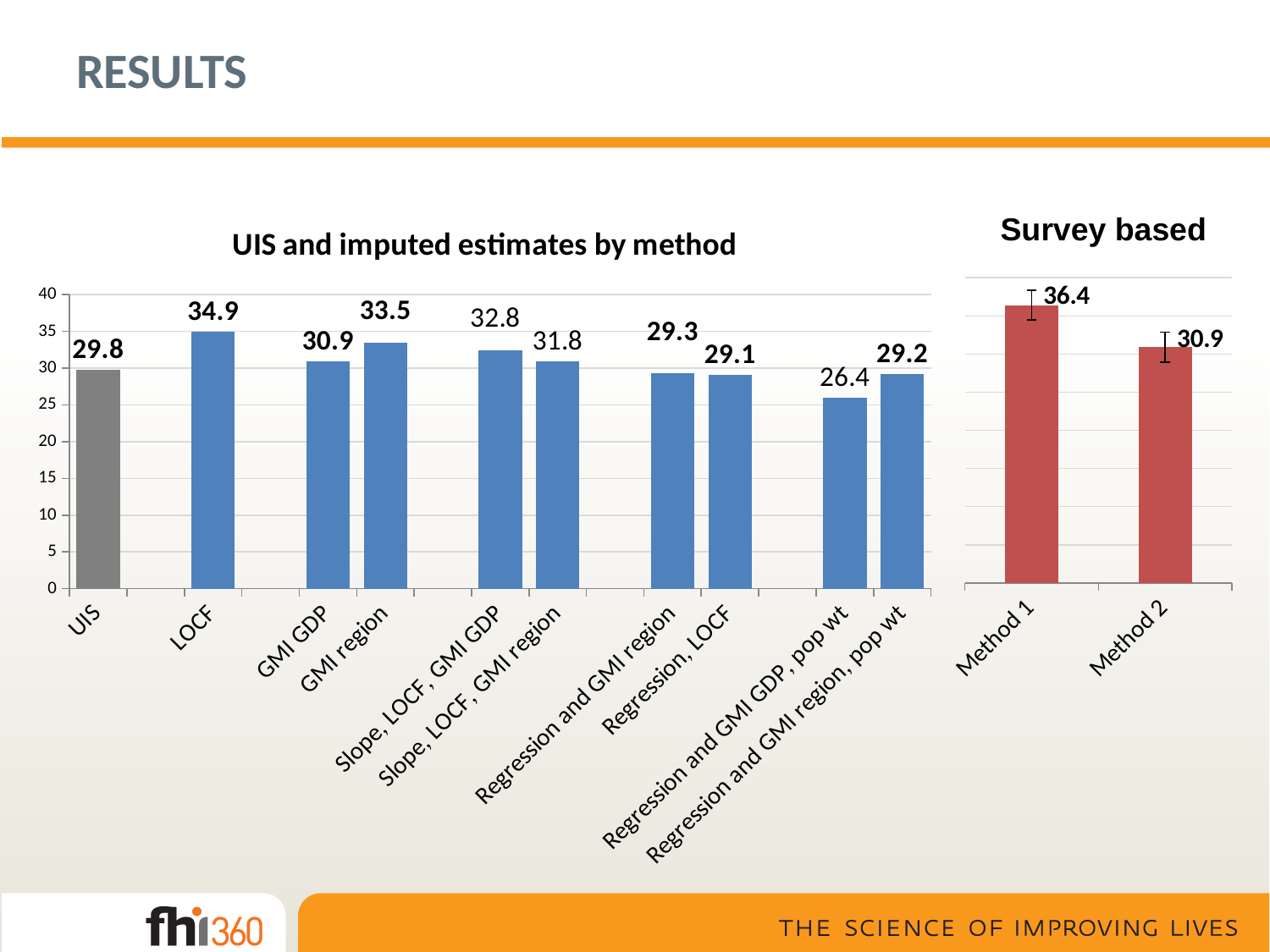
In the 'Survey based' chart, what is the difference between Method 1 and Method 2? 5.5 In the 'Survey based' chart, what is the value for Method 2? 30.9 In the 'UIS and imputed estimates by method' chart, which category has the lowest value? Regression and GMI GDP, pop wt In the 'UIS and imputed estimates by method' chart, which is larger: GMI GDP or GMI region? GMI region In the 'UIS and imputed estimates by method' chart, what is the value for UIS? 29.8 In the 'UIS and imputed estimates by method' chart, which category has the highest value? LOCF How many categories are shown in the 'UIS and imputed estimates by method' chart? 10 In the 'UIS and imputed estimates by method' chart, what is the difference between the LOCF value and the UIS value? 5.1 What type of chart is the 'Survey based' chart? Bar chart In the 'Survey based' chart, what is the value for Method 1? 36.4 In the 'UIS and imputed estimates by method' chart, what is the value for 'Regression and GMI GDP, pop wt'? 26.4 In the 'UIS and imputed estimates by method' chart, what is the value for LOCF? 34.9